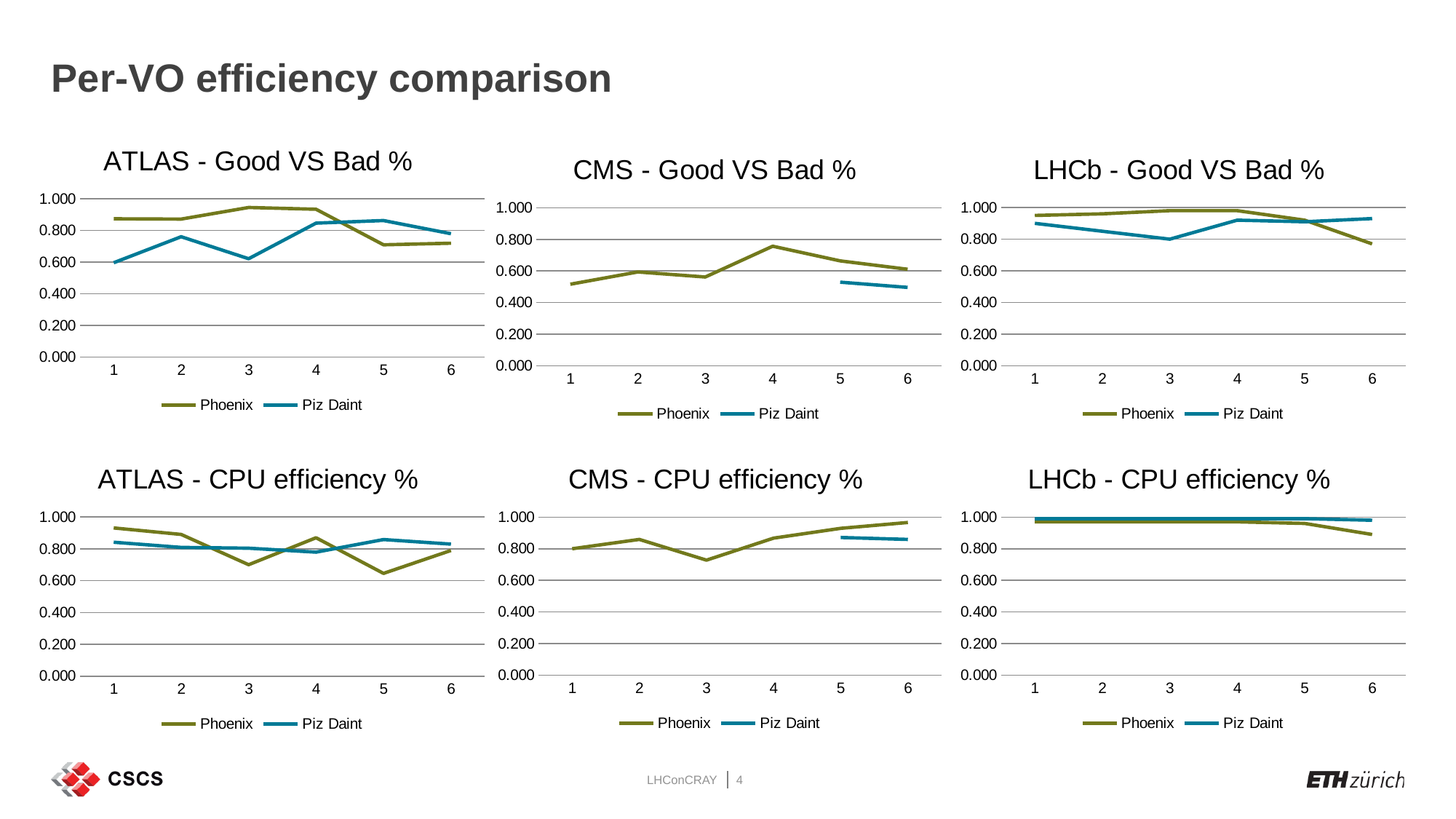
In the "ATLAS - CPU efficiency %" chart, is the Phoenix value at point 5 greater or less than 0.800? less In the "CMS - CPU efficiency %" chart, does the Phoenix series rise or fall from point 3 to point 6? rise In the "LHCb - Good VS Bad %" chart, which series has the larger value at point 3, Phoenix or Piz Daint? Phoenix In the "CMS - Good VS Bad %" chart, is the Phoenix value at point 1 greater or less than 0.600? less What kind of chart is the "ATLAS - Good VS Bad %" chart? Line chart How many series does the legend of the "CMS - CPU efficiency %" chart list? 2 In the "ATLAS - CPU efficiency %" chart, at which x-axis point is the Phoenix series lowest? 5 How many charts are shown on the slide? 6 In the "ATLAS - Good VS Bad %" chart, is the Phoenix value at point 3 greater or less than 0.800? greater How many points are on the x axis of the "LHCb - Good VS Bad %" chart? 6 In the "CMS - Good VS Bad %" chart, which series has the larger value at point 5, Phoenix or Piz Daint? Phoenix In the "LHCb - CPU efficiency %" chart, which series has the larger value at point 6, Phoenix or Piz Daint? Piz Daint